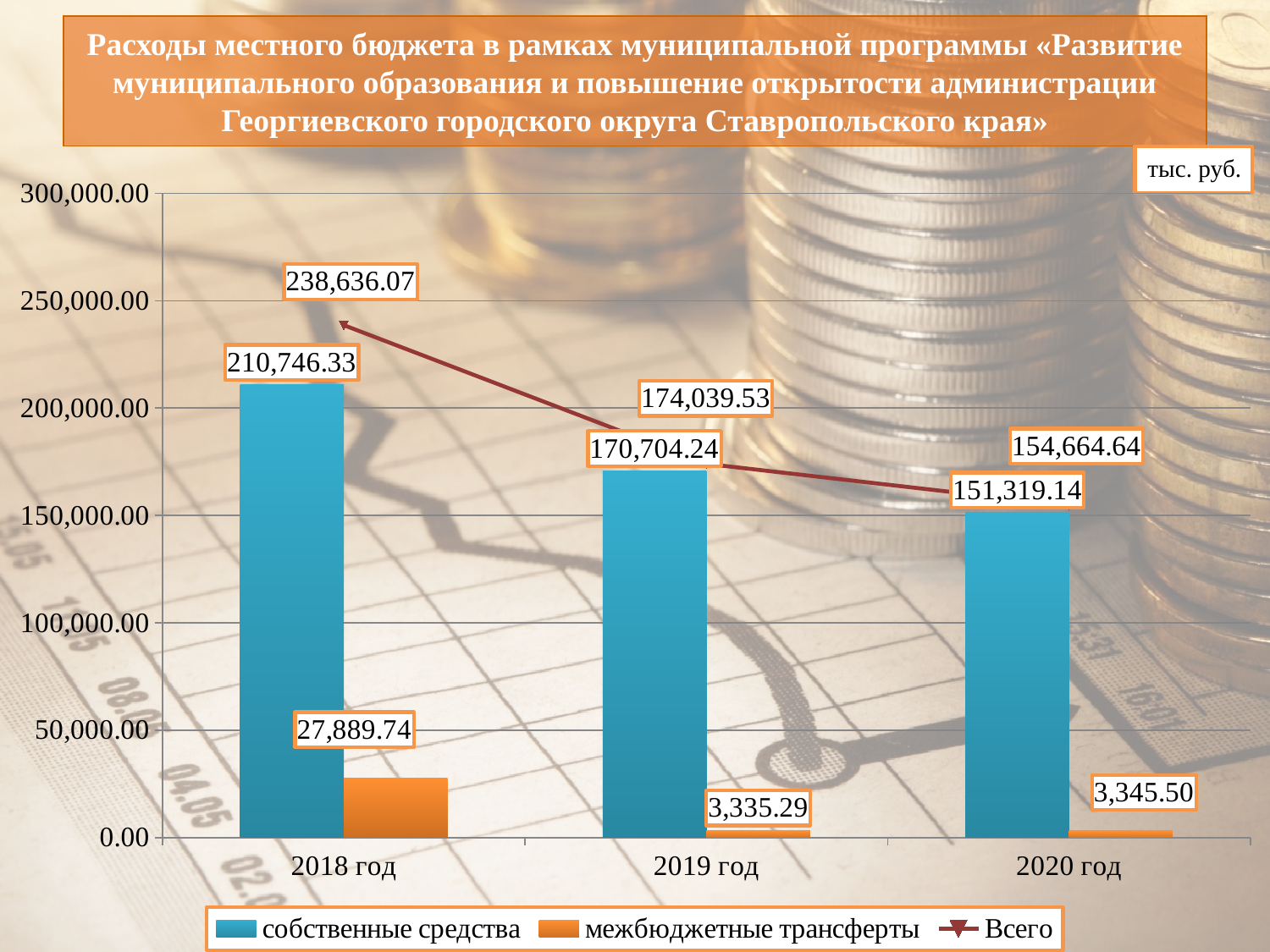
Каково значение «собственные средства» за 2018 год? 210,746.33 Каково значение «межбюджетные трансферты» за 2018 год? 27,889.74 Сколько категорий (лет) показано на оси x? 3 На сколько значение «собственные средства» за 2018 год больше, чем за 2019 год? 40,042.09 Каково значение «Всего» за 2020 год? 154,664.64 В каком году значение «Всего» наибольшее? 2018 год В каком году значение «собственные средства» наименьшее? 2020 год В каких единицах измерения приведены значения на диаграмме? тыс. руб. Как изменяется значение «Всего» с 2018 по 2020 год — растёт или падает? падает Каково значение «межбюджетные трансферты» за 2019 год? 3,335.29 Что больше: «межбюджетные трансферты» за 2019 год или за 2020 год? 2020 год Сколько рядов данных перечислено в легенде? 3